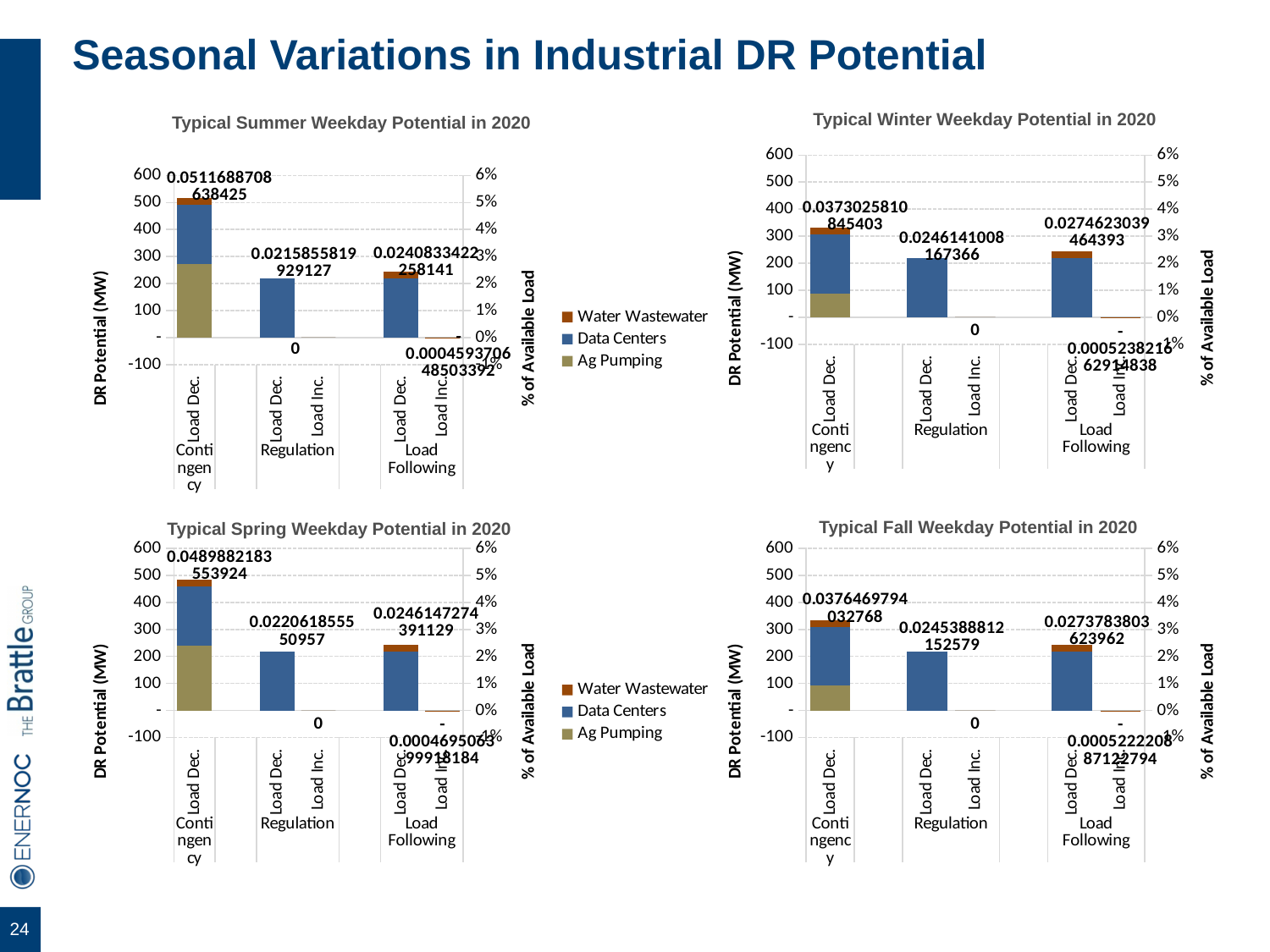
What kind of chart is the Typical Winter Weekday Potential in 2020 chart? Stacked bar chart In the Typical Spring Weekday Potential in 2020 chart, is the total DR Potential for Regulation Load Dec. greater or less than 100 MW? greater Which series in the legend of the Typical Summer Weekday Potential in 2020 chart is shown in the olive/tan colour? Ag Pumping In the Typical Summer Weekday Potential in 2020 chart, which is larger: the stacked bar for Contingency Load Dec. or for Regulation Load Dec.? Contingency Load Dec. What is the title of the chart in the bottom-left of the slide? Typical Spring Weekday Potential in 2020 How many series does the legend list for the Typical Summer Weekday Potential in 2020 chart? 3 In the Typical Summer Weekday Potential in 2020 chart, is the total DR Potential for Contingency Load Dec. greater or less than 400 MW? greater In the Typical Winter Weekday Potential in 2020 chart, is the total DR Potential for Contingency Load Dec. greater or less than 200 MW? greater In the Typical Fall Weekday Potential in 2020 chart, what is the % of Available Load data label shown for Load Following Load Dec.? 0.0273783803623962 In the Typical Winter Weekday Potential in 2020 chart, what is the % of Available Load data label shown for Regulation Load Dec.? 0.0246141008167366 In the Typical Fall Weekday Potential in 2020 chart, which category has the tallest stacked bar? Contingency Load Dec. In the Typical Spring Weekday Potential in 2020 chart, what data label is shown for Regulation Load Inc.? 0